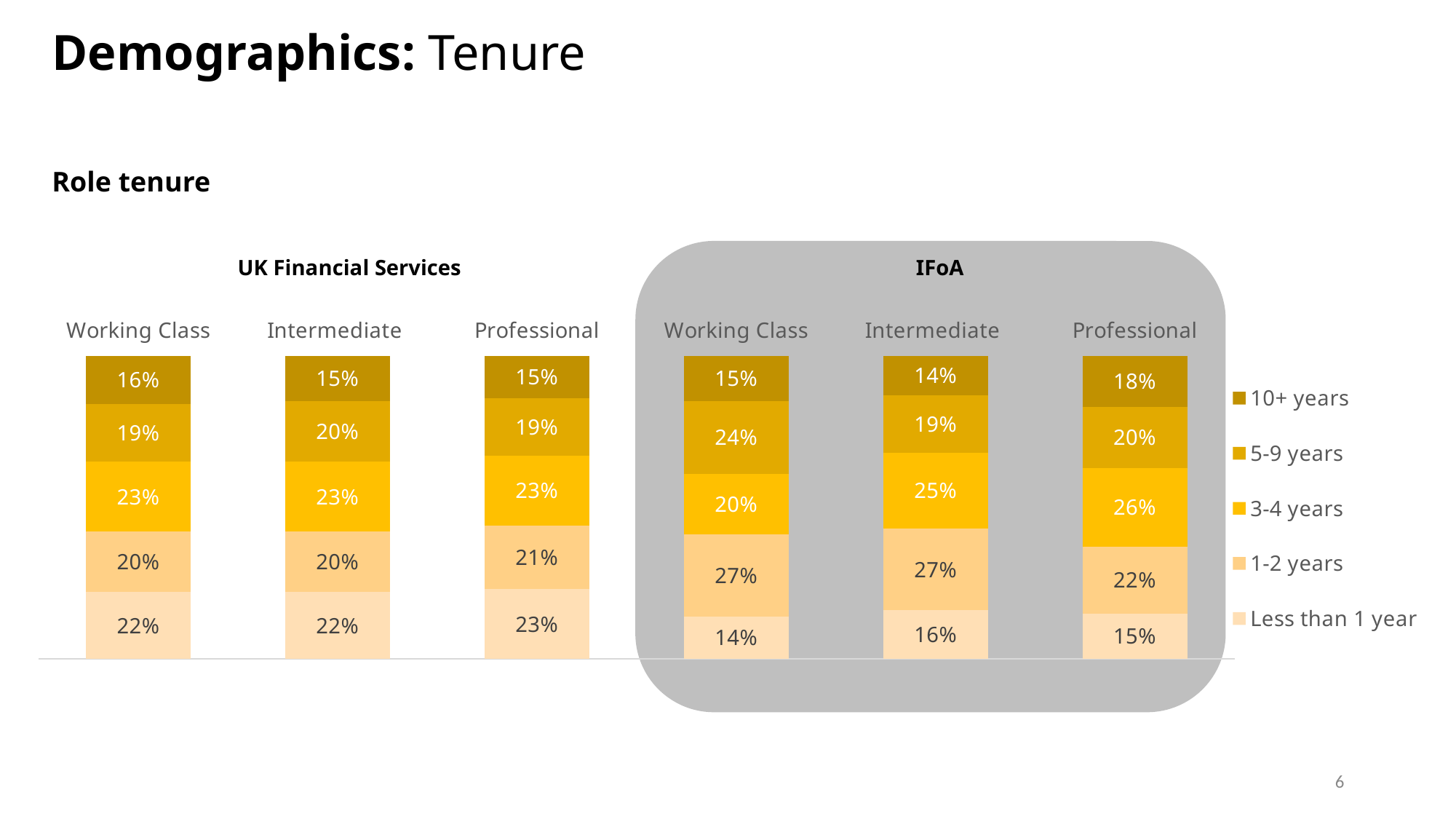
Which group has the highest share of 10+ years tenure? IFoA Professional What percentage of the IFoA Working Class group has 1-2 years of role tenure? 27% What type of chart is shown on the slide? Stacked bar chart Which group has the lowest share of less than 1 year tenure? IFoA Working Class What percentage of the UK Financial Services Professional group has less than 1 year of role tenure? 23% How many stacked bars are shown in the chart? 6 What is the 10+ years share for the IFoA Professional group? 18% Which two organisations or groups are the bars divided between? UK Financial Services and IFoA What is the 3-4 years share for the IFoA Intermediate group? 25% How many tenure categories does the legend list? 5 What is the difference between the 1-2 years share for IFoA Working Class and UK Financial Services Working Class? 7 percentage points Which has a larger 5-9 years share: IFoA Working Class or IFoA Intermediate? IFoA Working Class